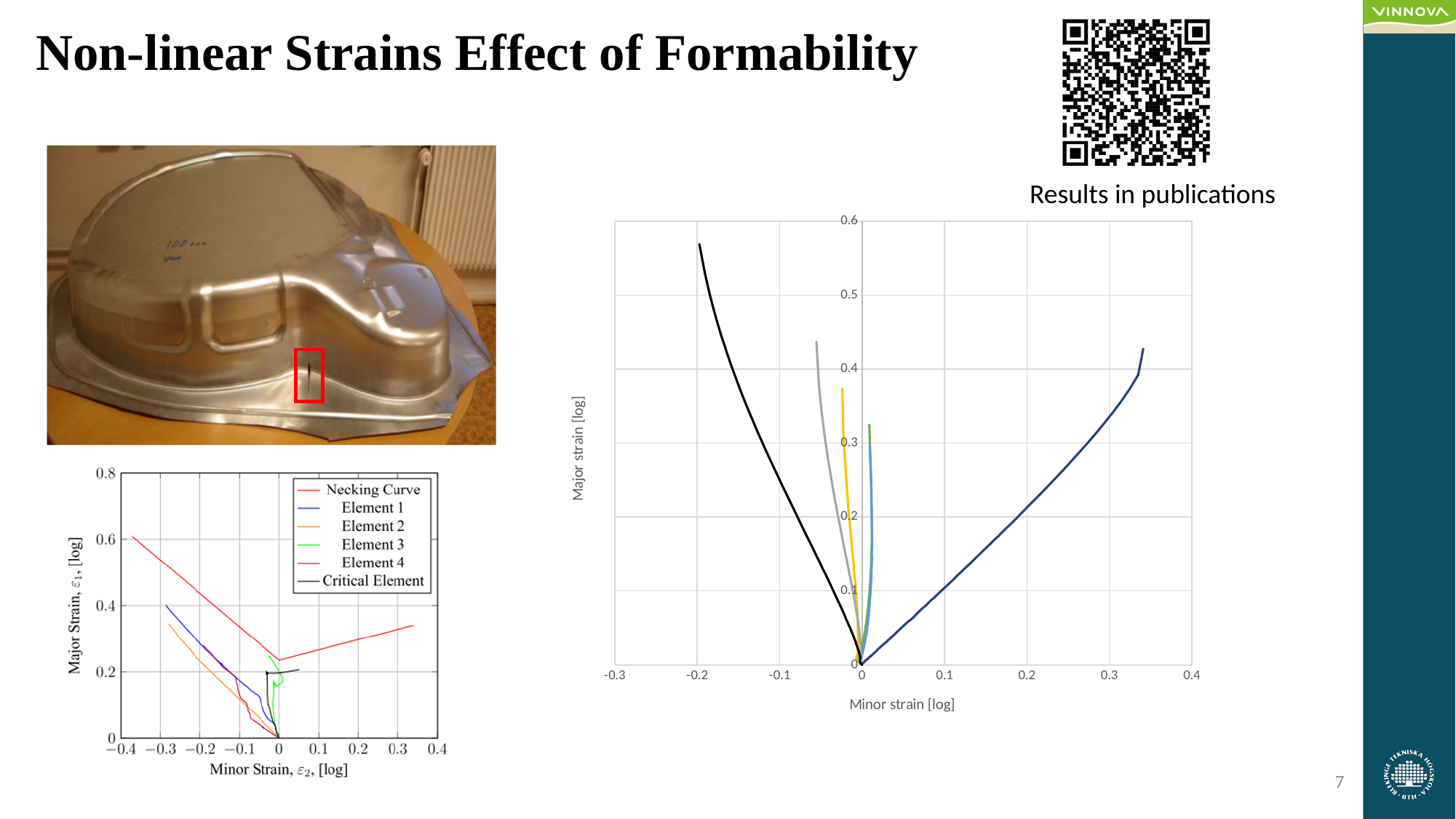
In the bottom-left chart, is the highest major strain reached by the Critical Element greater or less than 0.4? less In the right-hand chart, which line reaches a higher major strain, the black line or the grey line? The black line In the bottom-left chart, is the highest major strain reached by the Necking Curve greater or less than 0.4? greater In the bottom-left chart, what colour is the Necking Curve drawn in? Red What kind of chart is the bottom-left chart with the Necking Curve? Line chart In the bottom-left chart, which reaches a higher major strain, Element 1 or the Critical Element? Element 1 How many series does the legend of the bottom-left chart list? 6 What kind of chart is the large chart on the right of the slide? Line chart What is the highest tick value on the y axis of the bottom-left chart? 0.8 In the bottom-left chart, which series reaches the highest major strain? Necking Curve In the right-hand chart, is the highest major strain reached by the black line greater or less than 0.5? greater